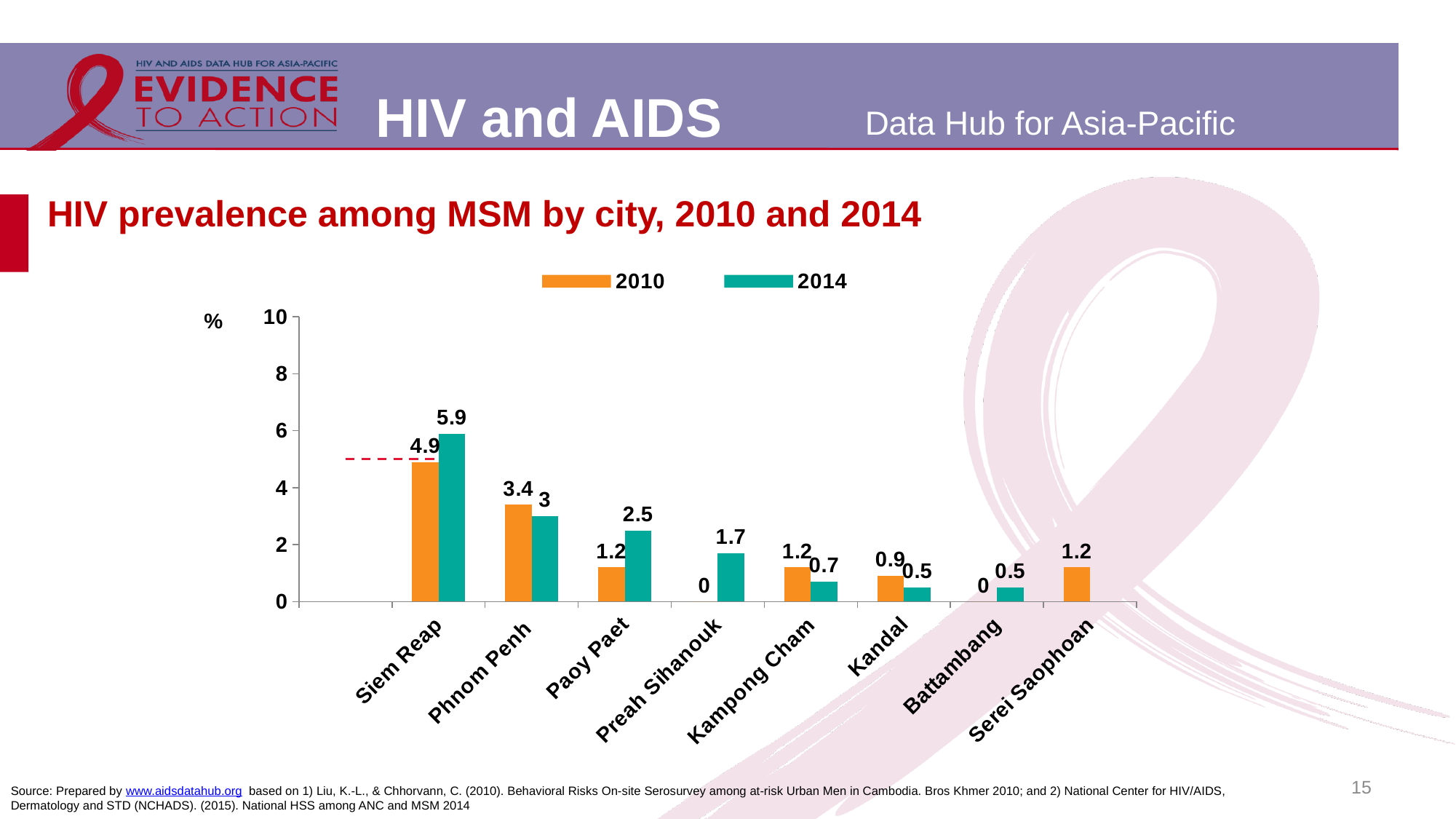
Which city has the lowest 2014 value among those with a 2014 bar? Kandal and Battambang (0.5) How many cities are shown on the x axis? 8 What value is shown for Preah Sihanouk in 2010? 0 By how much did HIV prevalence among MSM in Paoy Paet change from 2010 to 2014? 1.3 Is the 2014 value for Siem Reap greater or less than 4? greater How many series does the legend list? 2 What was the HIV prevalence among MSM in Phnom Penh in 2010? 3.4 What unit is shown on the y axis of the chart? % What was the HIV prevalence among MSM in Siem Reap in 2014? 5.9 Which is larger for Kampong Cham: the 2010 value or the 2014 value? 2010 Which city has the highest HIV prevalence among MSM in 2014? Siem Reap What kind of chart is shown on the slide? Bar chart